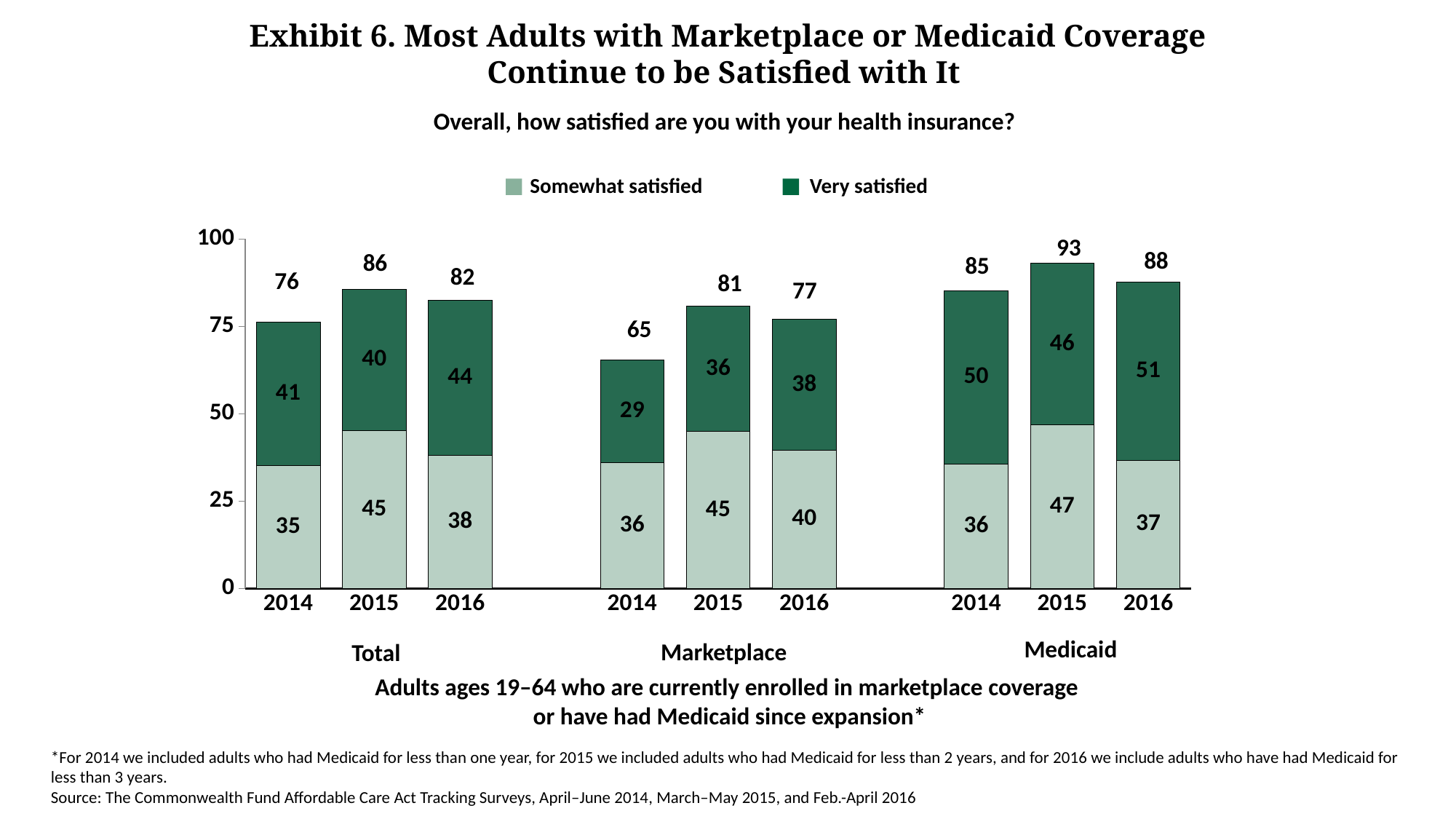
What kind of chart is shown on the slide? Stacked bar chart What is the 'Somewhat satisfied' value for Marketplace in 2016? 40 Which group and year has the highest stacked bar total? Medicaid 2015 Which group and year has the lowest stacked bar total? Marketplace 2014 Is the stacked bar total for Marketplace 2014 greater or less than 75? less How many series does the legend list? 2 How many stacked bars are shown in the chart? 9 Which series is shown in the darker green colour? Very satisfied What is the 'Very satisfied' value for Medicaid in 2015? 46 What is the total of the stacked bar for Total in 2014? 76 What is the difference between the 'Very satisfied' values for Medicaid 2016 and Marketplace 2016? 13 Which is larger: the 'Somewhat satisfied' value for Total 2015 or for Medicaid 2015? Medicaid 2015